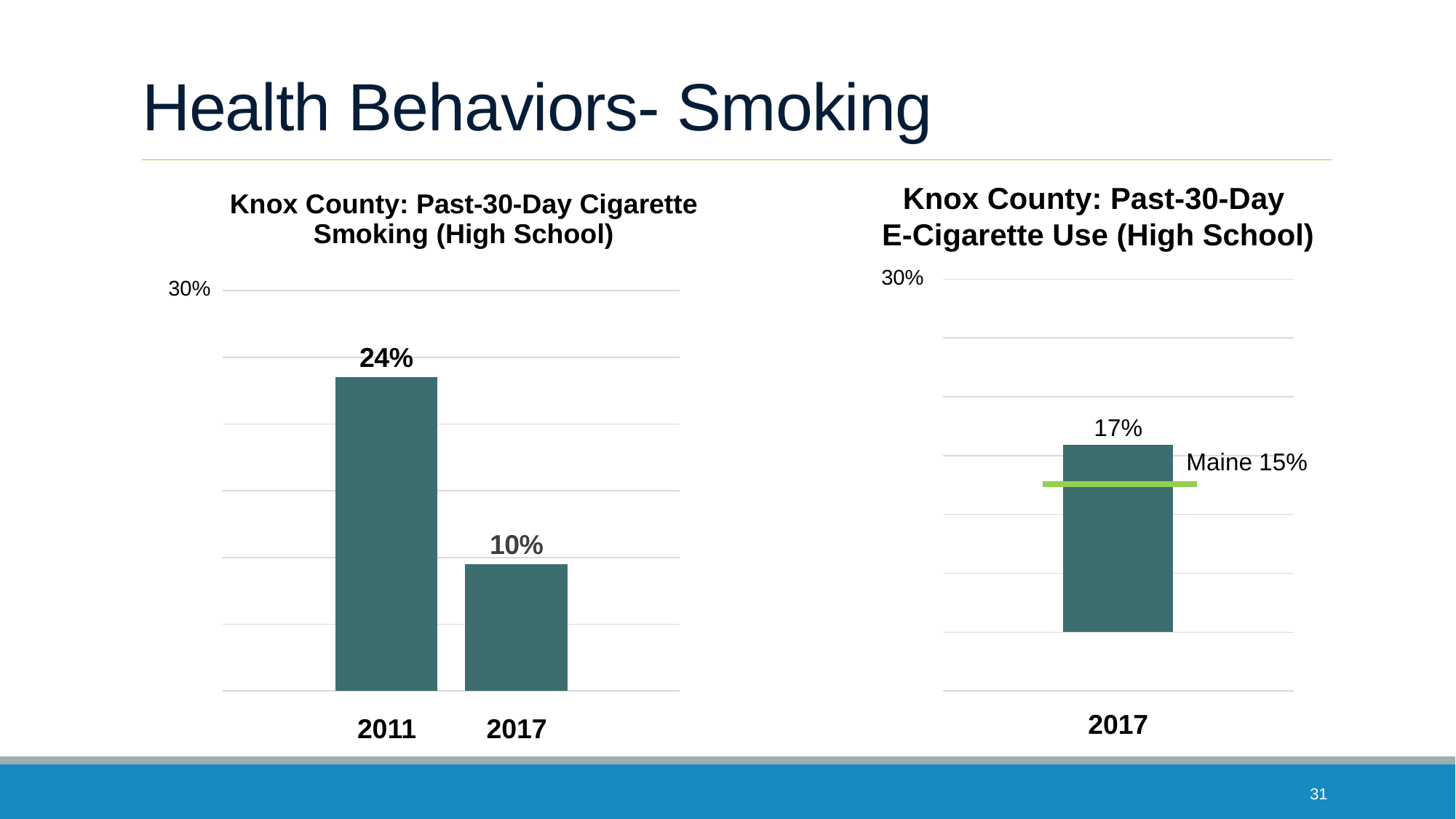
In the 'Knox County: Past-30-Day Cigarette Smoking (High School)' chart, which year has the lowest value? 2017 In the 'Knox County: Past-30-Day E-Cigarette Use (High School)' chart, what Maine value is marked by the green line? Maine 15% In the 'Knox County: Past-30-Day E-Cigarette Use (High School)' chart, what is the value for 2017? 17% In the 'Knox County: Past-30-Day Cigarette Smoking (High School)' chart, what is the value for 2011? 24% In the 'Knox County: Past-30-Day E-Cigarette Use (High School)' chart, is the 2017 value greater or less than 30%? less In the 'Knox County: Past-30-Day Cigarette Smoking (High School)' chart, do the values rise or fall from 2011 to 2017? fall What kind of chart is the 'Knox County: Past-30-Day Cigarette Smoking (High School)' chart? bar chart In the 'Knox County: Past-30-Day E-Cigarette Use (High School)' chart, which is larger: the Knox County 2017 value or the Maine value? Knox County 2017 value In the 'Knox County: Past-30-Day Cigarette Smoking (High School)' chart, what is the difference between the 2011 and 2017 values? 14% In the 'Knox County: Past-30-Day Cigarette Smoking (High School)' chart, what is the value for 2017? 10% In the 'Knox County: Past-30-Day Cigarette Smoking (High School)' chart, which year has the highest value? 2011 How many bars are shown in the 'Knox County: Past-30-Day Cigarette Smoking (High School)' chart? 2